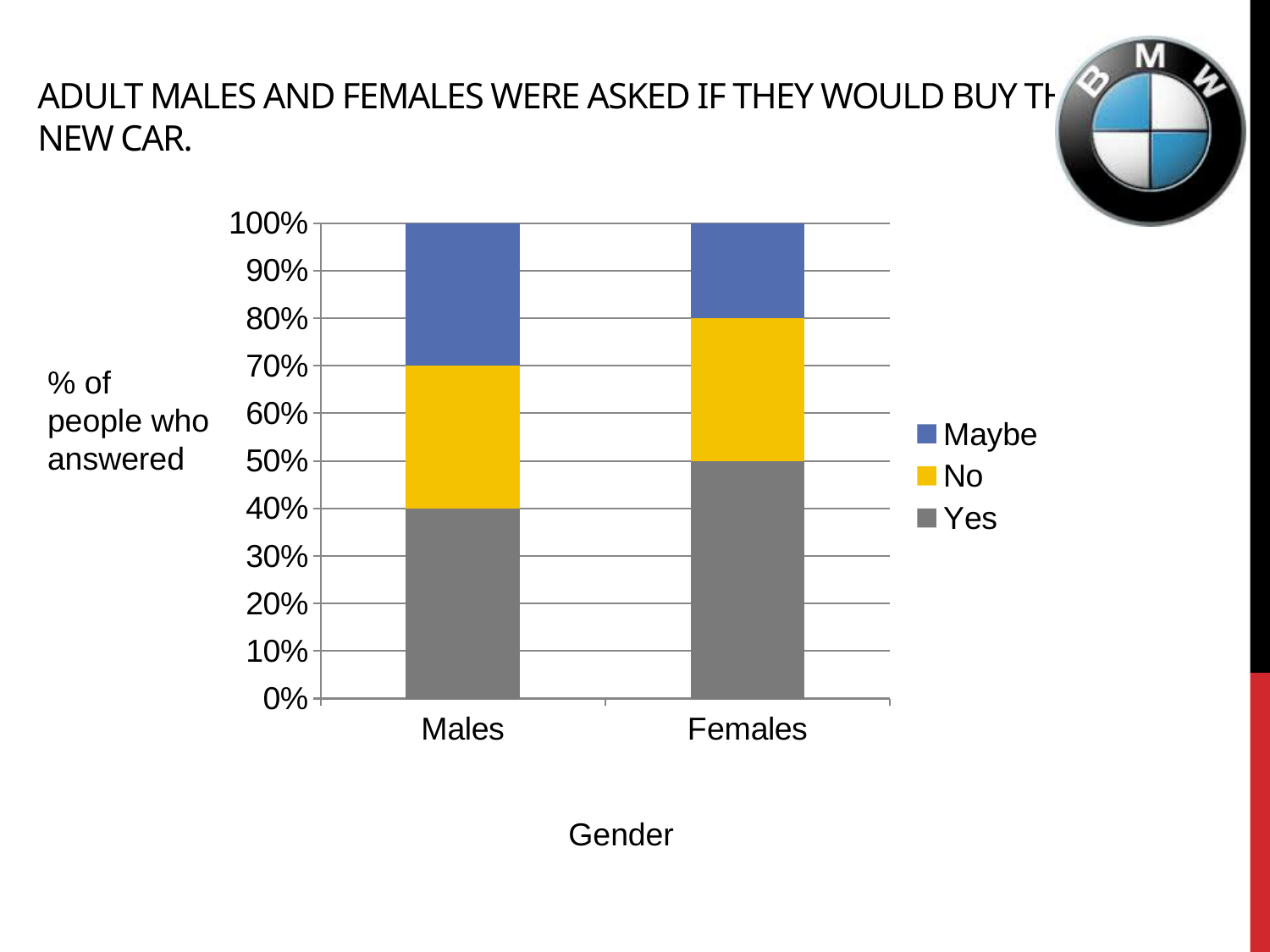
What percentage of Males answered Maybe? 30% Which gender has the larger share of Maybe answers? Males What is the difference between the Yes share for Females and the Yes share for Males? 10% Which gender has the larger share of Yes answers? Females How many categories are shown on the x axis? 2 What percentage of Females answered Maybe? 20% How many series does the legend list? 3 What percentage of Females answered Yes? 50% What percentage of Males answered Yes? 40% What kind of chart is shown on the slide? stacked bar chart What is the total height of the Males stacked bar? 100% What is the label on the x axis? Gender